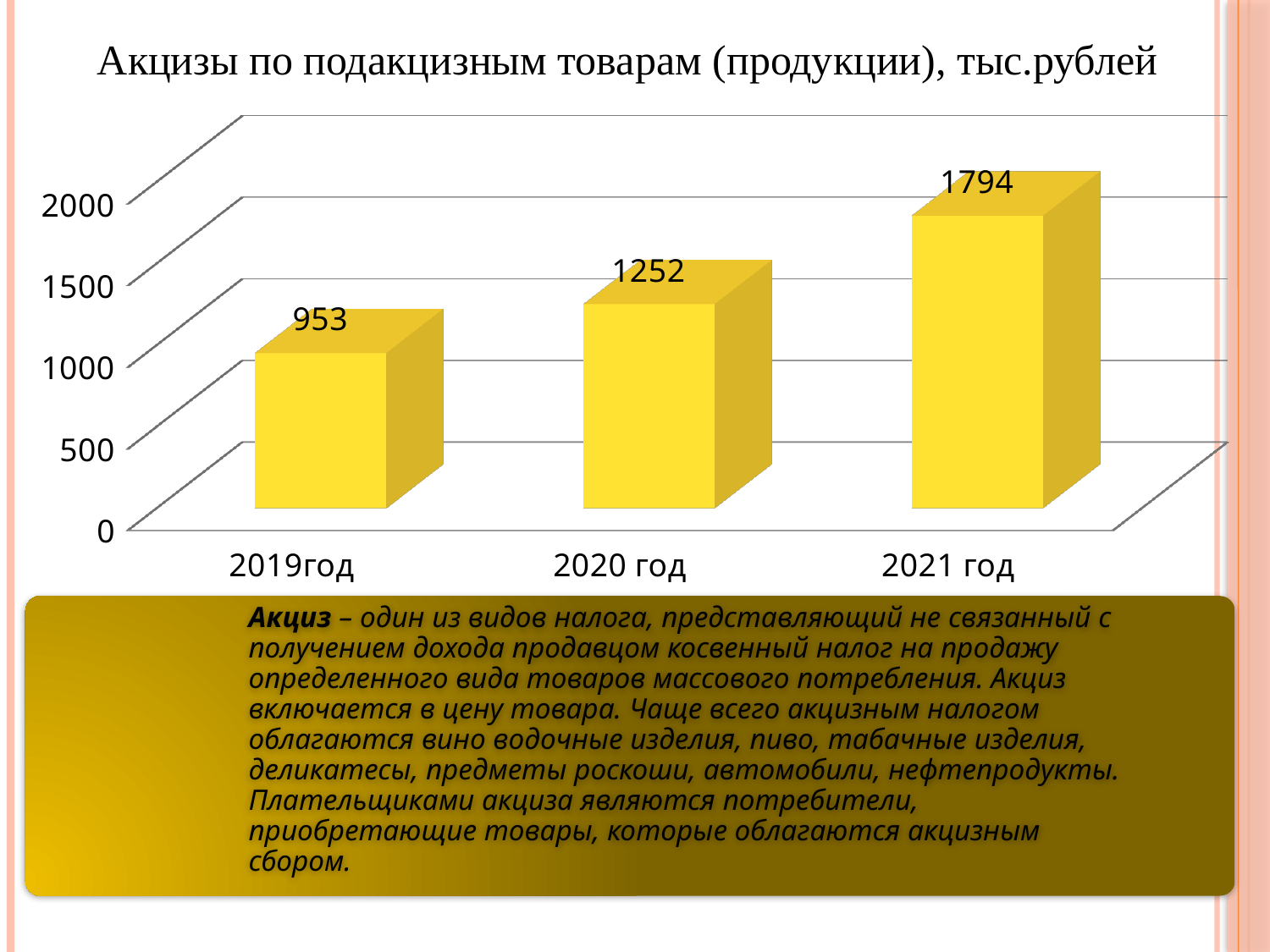
What is the value for 2020 год? 1252 What is the value for 2021 год? 1794 What kind of chart is shown on the slide? bar chart What is the value for 2019год? 953 What is the difference between the values for 2021 год and 2019год? 841 What is the difference between the values for 2020 год and 2019год? 299 Is the value for 2019год greater or less than 1000? less Which year has the highest value? 2021 год Do the values rise or fall from 2019год to 2021 год? rise Which year has the lowest value? 2019год How many years are shown on the chart? 3 Which is larger, the value for 2020 год or the value for 2021 год? 2021 год